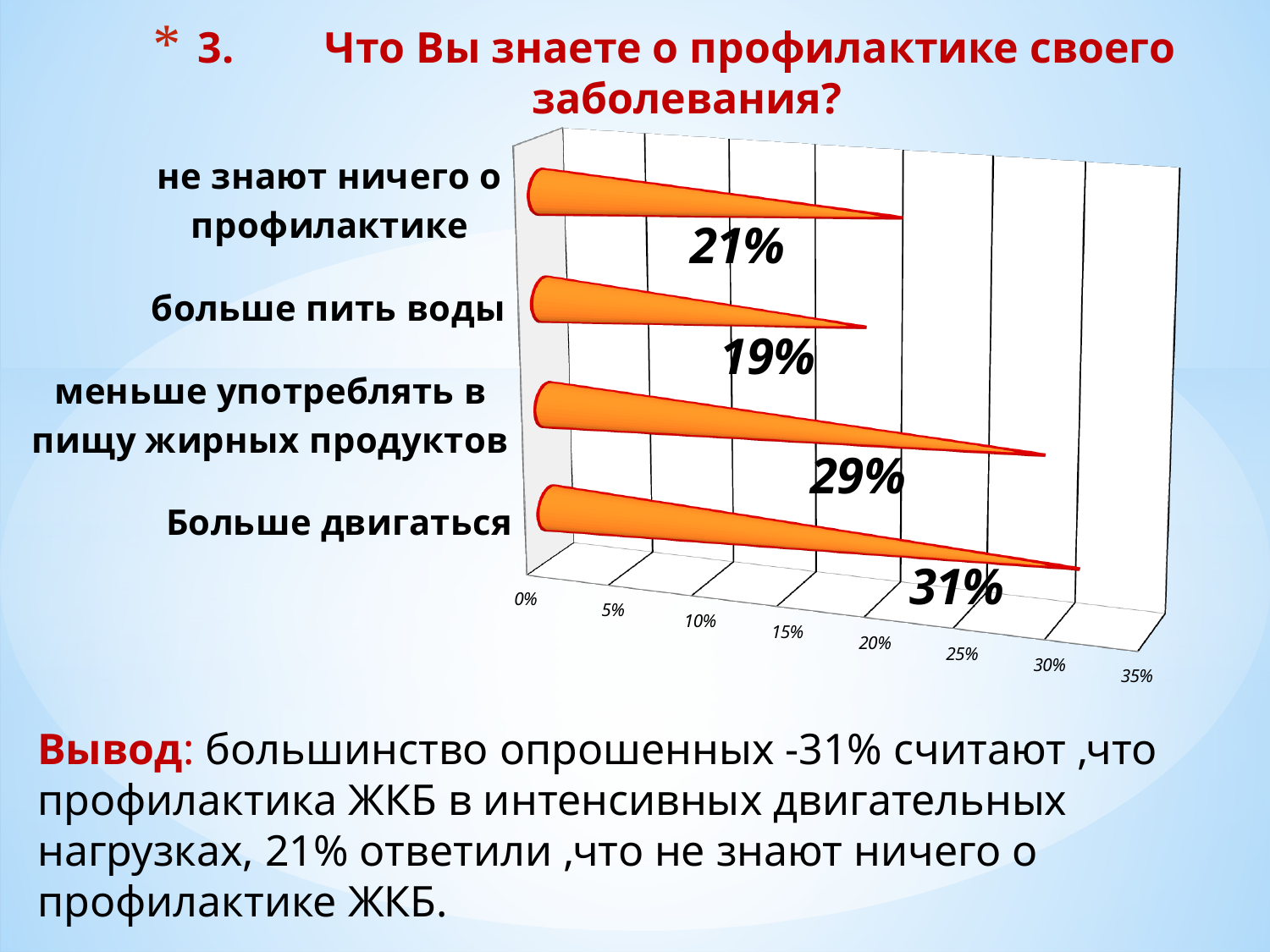
What is the value for "больше пить воды"? 19% What kind of chart is shown on the slide? bar chart Which is larger: the value for "не знают ничего о профилактике" or for "больше пить воды"? не знают ничего о профилактике What is the value for "меньше употреблять в пищу жирных продуктов"? 29% Which category has the lowest value? больше пить воды What is the value for "Больше двигаться"? 31% Which category has the highest value? Больше двигаться What is the difference between the values for "Больше двигаться" and "больше пить воды"? 12% What is the difference between the values for "меньше употреблять в пищу жирных продуктов" and "не знают ничего о профилактике"? 8% How many categories are shown in the chart? 4 What is the value for "не знают ничего о профилактике"? 21% What is the maximum value shown on the horizontal axis? 35%